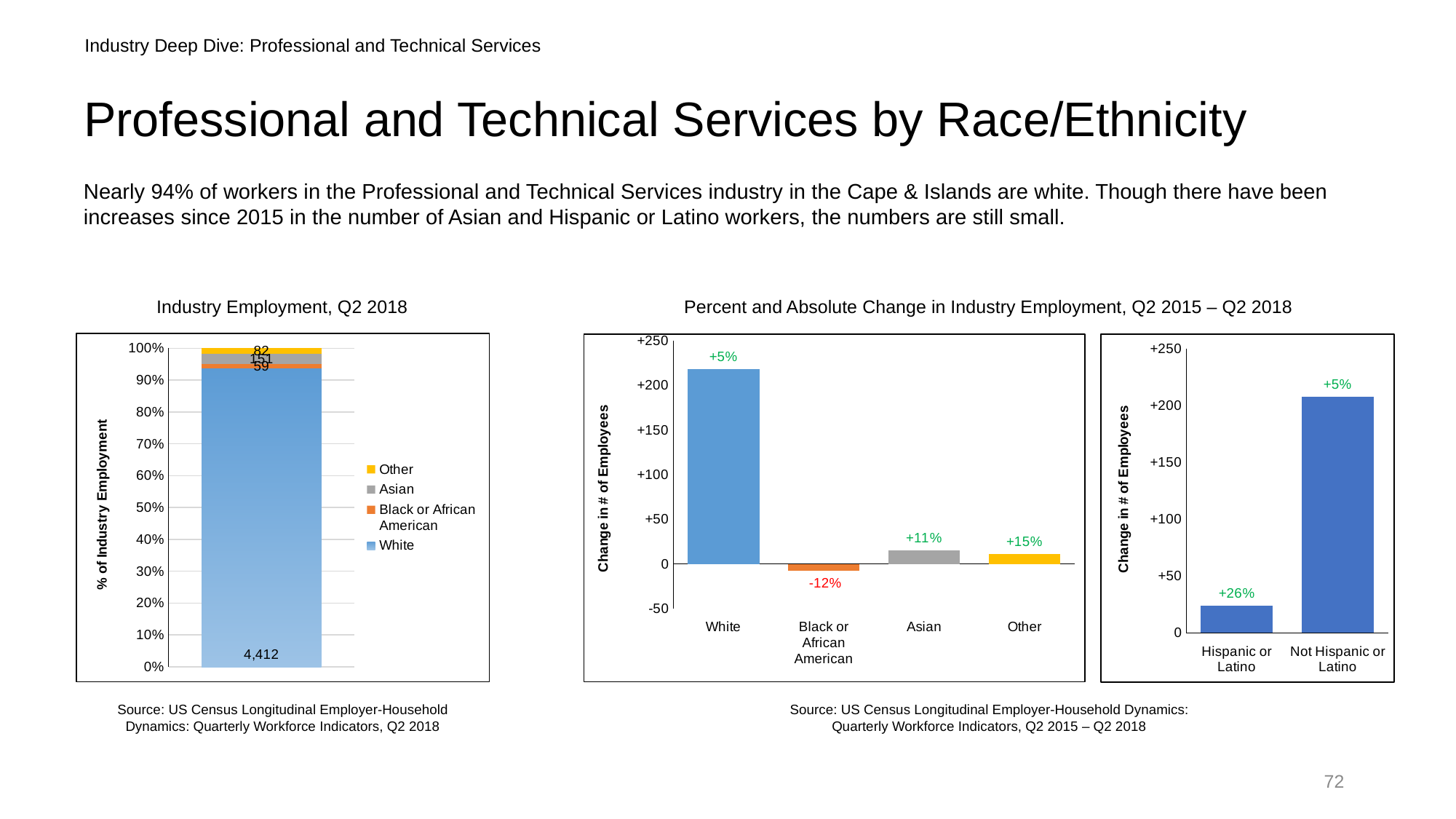
How many series does the legend of the 'Industry Employment, Q2 2018' chart list? 4 In the middle chart (Percent and Absolute Change in Industry Employment by race), which category has the largest change in number of employees? White In the middle chart (Percent and Absolute Change in Industry Employment by race), is the change in number of employees for White greater or less than +200? greater In the rightmost chart (change in employment by Hispanic or Latino status), what percent change is labelled for Hispanic or Latino? +26% In the middle chart (Percent and Absolute Change in Industry Employment by race), what percent change is labelled for Black or African American? -12% In the rightmost chart (change in employment by Hispanic or Latino status), is the change in number of employees for Hispanic or Latino greater or less than +50? less What kind of chart is the 'Industry Employment, Q2 2018' chart? Stacked bar chart In the middle chart (Percent and Absolute Change in Industry Employment by race), which category has the lowest change in number of employees? Black or African American How many categories are shown on the x axis of the middle chart (Percent and Absolute Change in Industry Employment by race)? 4 In the 'Industry Employment, Q2 2018' chart, what value is labelled on the Black or African American segment? 59 In the middle chart (Percent and Absolute Change in Industry Employment by race), what percent change is labelled for White? +5% In the 'Industry Employment, Q2 2018' chart, what value is labelled on the White segment? 4,412